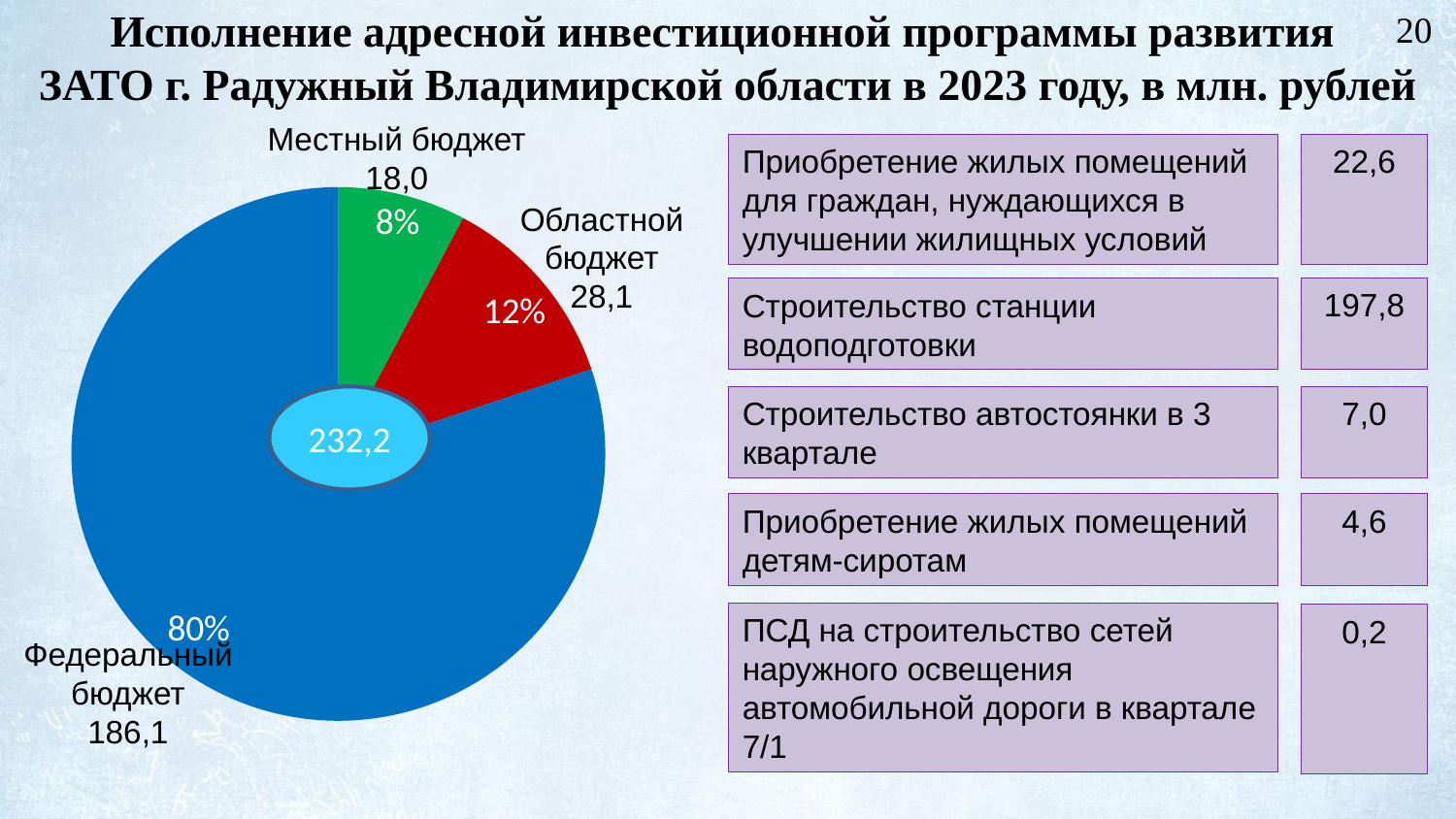
What type of chart is shown on the slide? Pie chart Which slice of the pie chart is the largest? Федеральный бюджет What is the value for Федеральный бюджет in the pie chart? 186,1 How many slices does the pie chart have? 3 Which slice of the pie chart is the smallest? Местный бюджет What share of the pie does Областной бюджет represent? 12% What is the value for Местный бюджет in the pie chart? 18,0 What is the value for Областной бюджет in the pie chart? 28,1 What share of the pie does Местный бюджет represent? 8% What total value is shown in the centre of the pie chart? 232,2 What share of the pie does Федеральный бюджет represent? 80% What is the difference between the values for Областной бюджет and Местный бюджет? 10,1